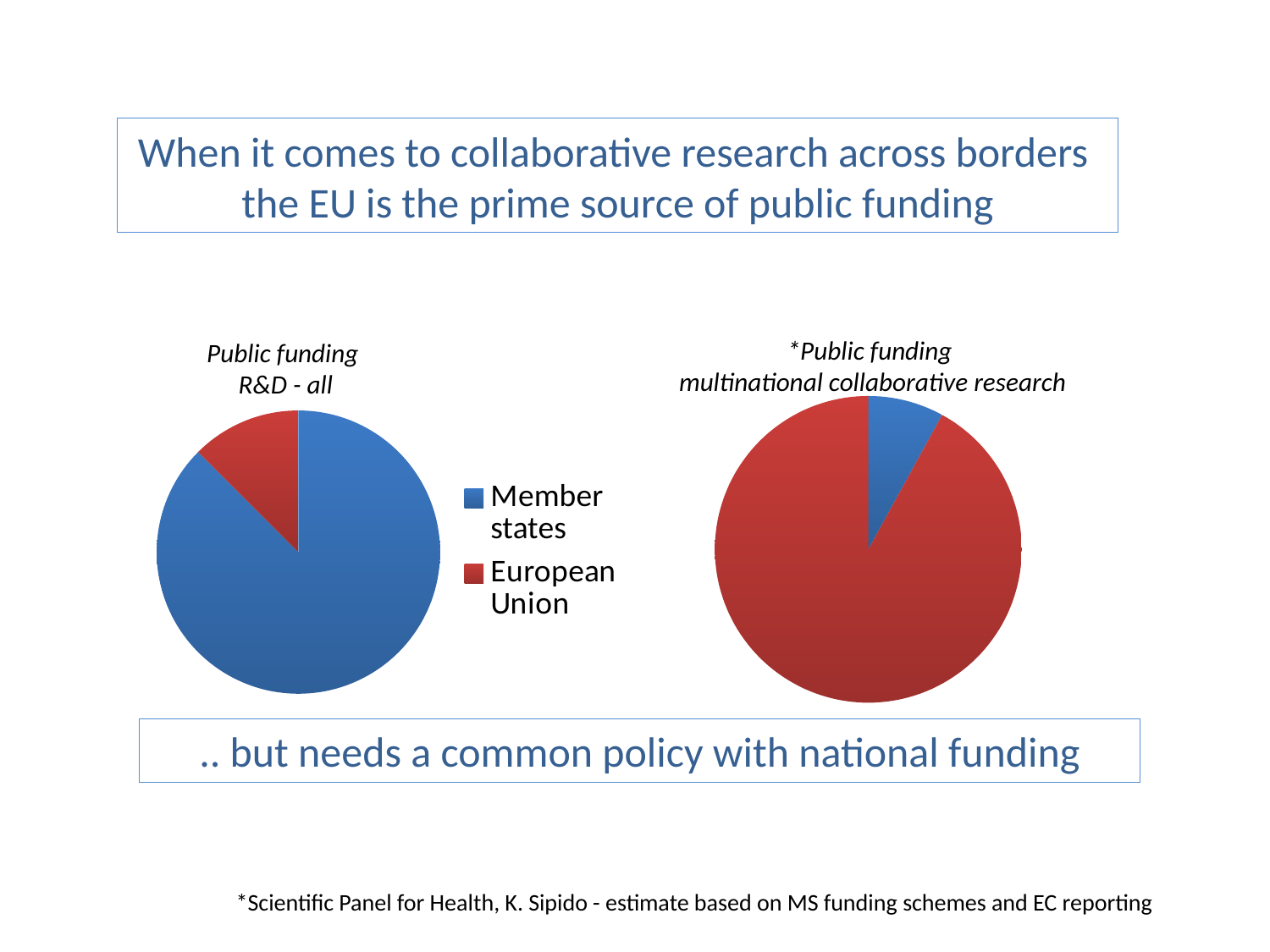
Which colour represents European Union in the pie charts? red In the "Public funding multinational collaborative research" pie chart, which category has the largest slice? European Union In the "Public funding R&D - all" pie chart, which category has the largest slice? Member states In the "Public funding R&D - all" pie chart, which category has the smallest slice? European Union What kind of chart is the "Public funding R&D - all" chart? pie chart How many slices does the "Public funding multinational collaborative research" pie chart have? 2 How many entries does the legend between the two pie charts list? 2 What kind of chart is the "Public funding multinational collaborative research" chart? pie chart In the "Public funding multinational collaborative research" pie chart, is the European Union slice larger or smaller than the Member states slice? larger In the "Public funding multinational collaborative research" pie chart, which category has the smallest slice? Member states What is the title of the pie chart on the left of the slide? Public funding R&D - all How many slices does the "Public funding R&D - all" pie chart have? 2